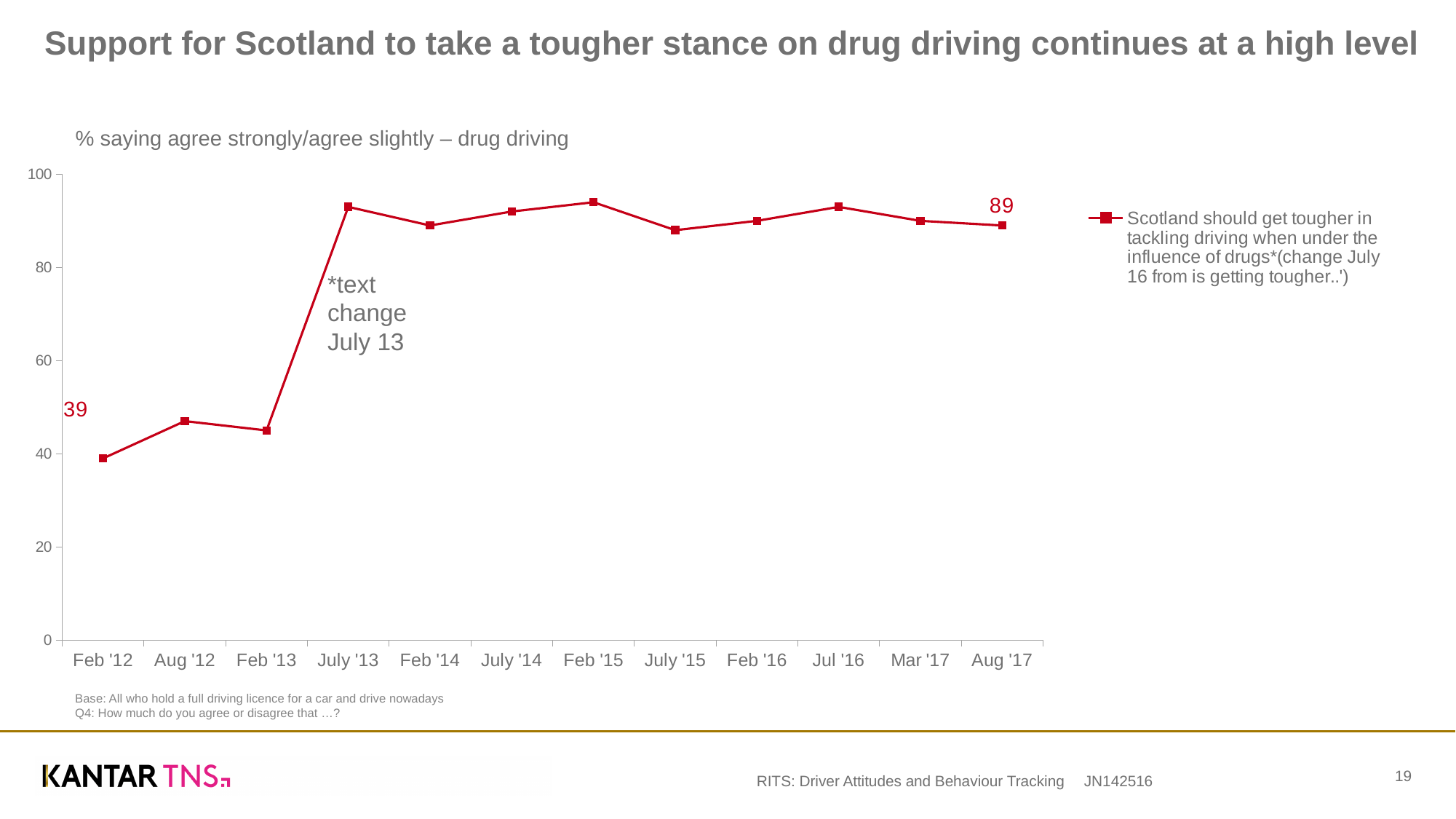
Does the value rise or fall between Feb '12 and July '13? Rise What is the value for Feb '12? 39 What is the difference between the Aug '17 value and the Feb '12 value? 50 Is the value for July '15 greater or less than 80? greater What kind of chart is shown on the slide? Line chart What annotation is placed next to the July '13 point? *text change July 13 How many time points are plotted on the x axis? 12 Which is larger, the value for Feb '13 or the value for July '13? July '13 Which time point has the lowest value? Feb '12 How many series does the legend list? 1 What is the value for Aug '17? 89 Is the value for Feb '13 greater or less than 60? less